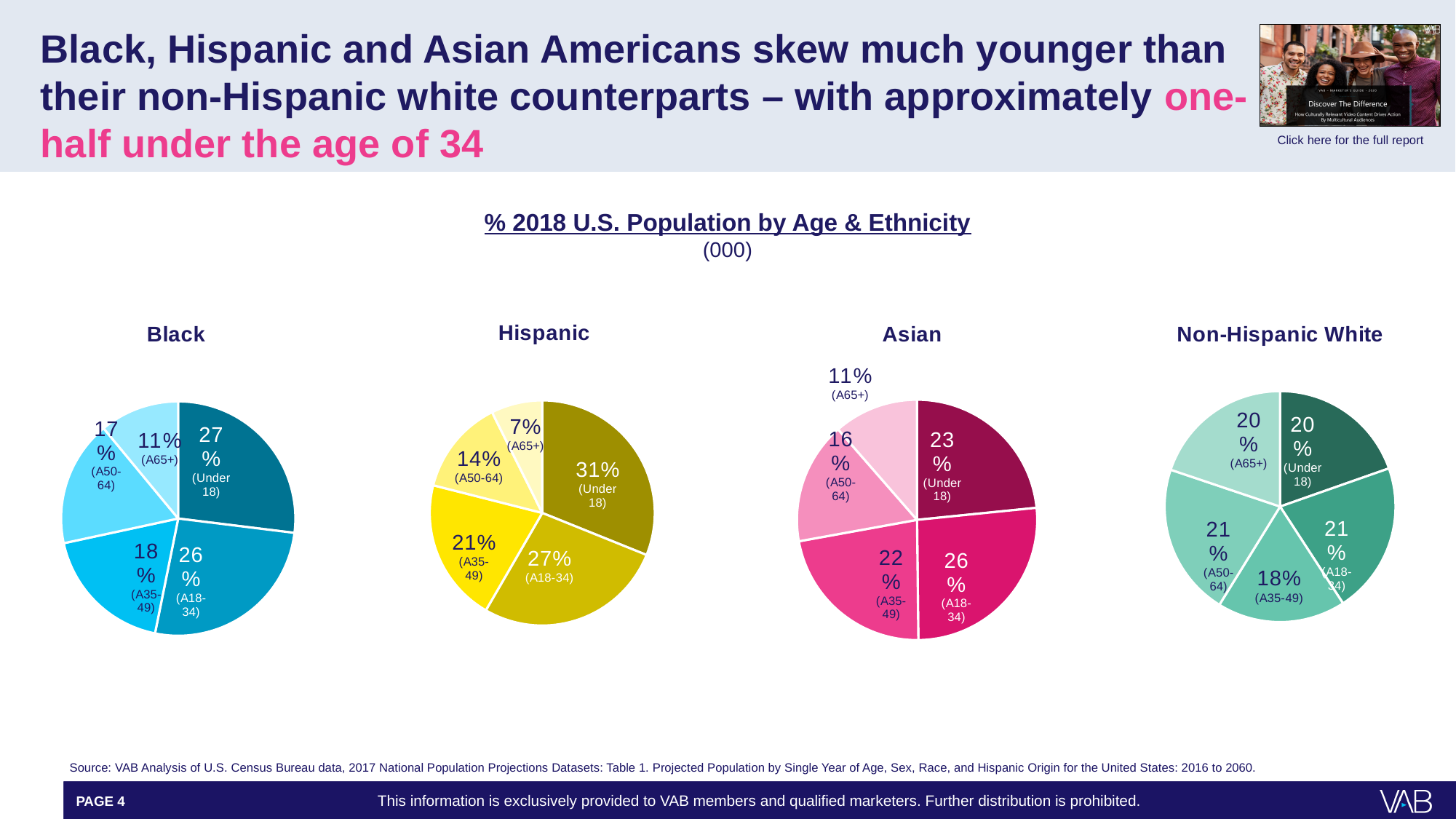
How many pie charts are shown on the slide? 4 In the Black pie chart, which age group has the smallest share? A65+ What kind of chart is used to show the Black population by age? Pie chart In the Hispanic pie chart, what share of the population is A65+? 7% In the Black pie chart, what share of the population is Under 18? 27% In the Hispanic pie chart, what is the difference between the Under 18 share and the A50-64 share? 17% In the Non-Hispanic White pie chart, what share of the population is A35-49? 18% In the Hispanic pie chart, which age group has the largest share? Under 18 In the Asian pie chart, what share of the population is A18-34? 26% How many slices does the Asian pie chart have? 5 In the Asian pie chart, what is the difference between the A18-34 share and the A65+ share? 15% Which is larger: the Under 18 share in the Hispanic pie chart or the Under 18 share in the Non-Hispanic White pie chart? Hispanic